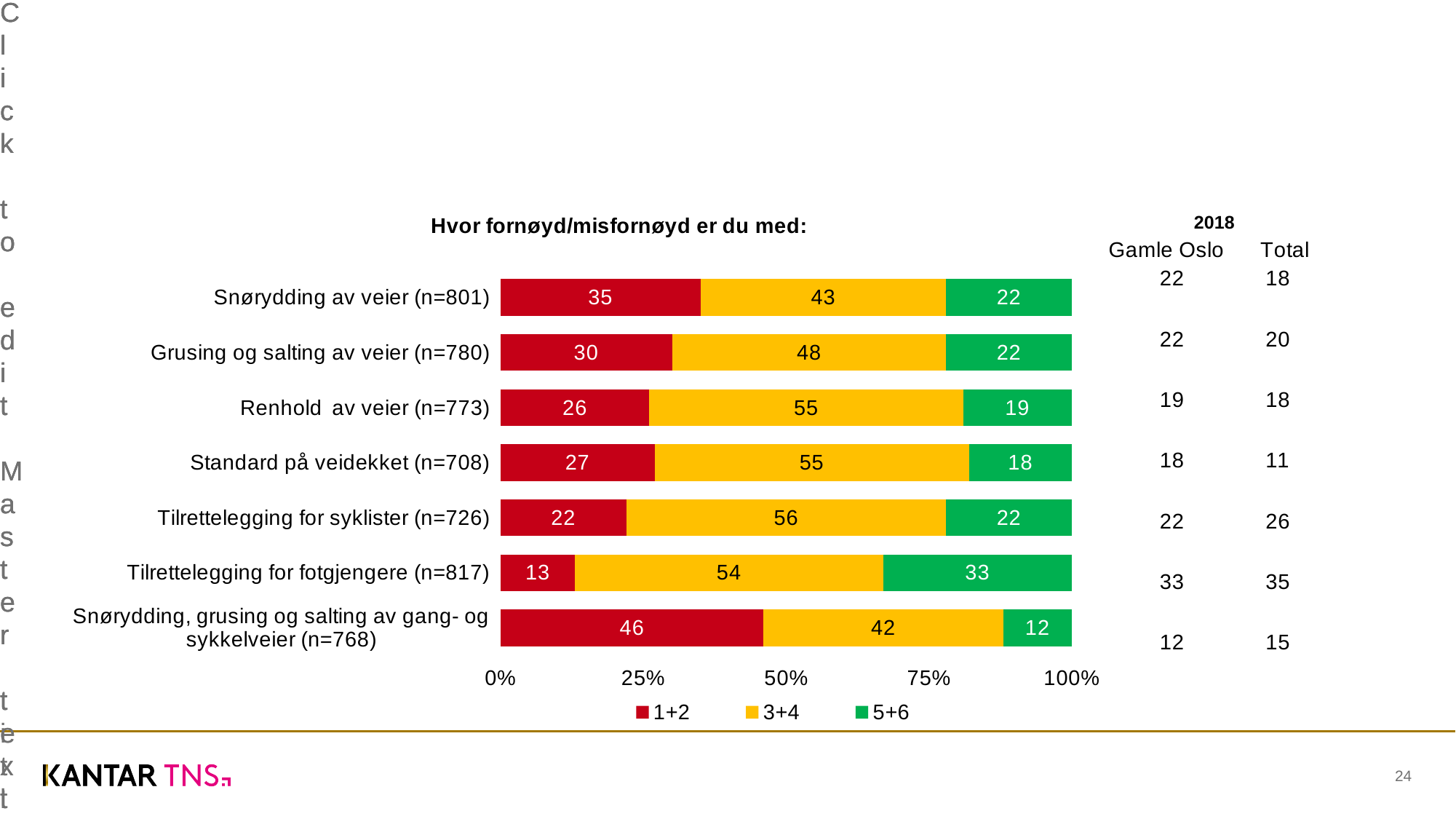
What is the value of the 1+2 series for Snørydding av veier (n=801)? 35 What is the title of the chart? Hvor fornøyd/misfornøyd er du med: What is the value of the 5+6 series for Tilrettelegging for fotgjengere (n=817)? 33 Which is larger: the 3+4 value for Renhold av veier (n=773) or the 3+4 value for Snørydding av veier (n=801)? Renhold av veier (n=773) What is the value of the 3+4 series for Tilrettelegging for syklister (n=726)? 56 What is the total of the stacked bar for Standard på veidekket (n=708)? 100 Which category has the highest value for the 1+2 series? Snørydding, grusing og salting av gang- og sykkelveier (n=768) How many series does the legend list? 3 Which category has the lowest value for the 5+6 series? Snørydding, grusing og salting av gang- og sykkelveier (n=768) How many categories are plotted in the chart? 7 What kind of chart is shown on the slide? Stacked bar chart What is the difference between the 1+2 values for Snørydding av veier (n=801) and Grusing og salting av veier (n=780)? 5